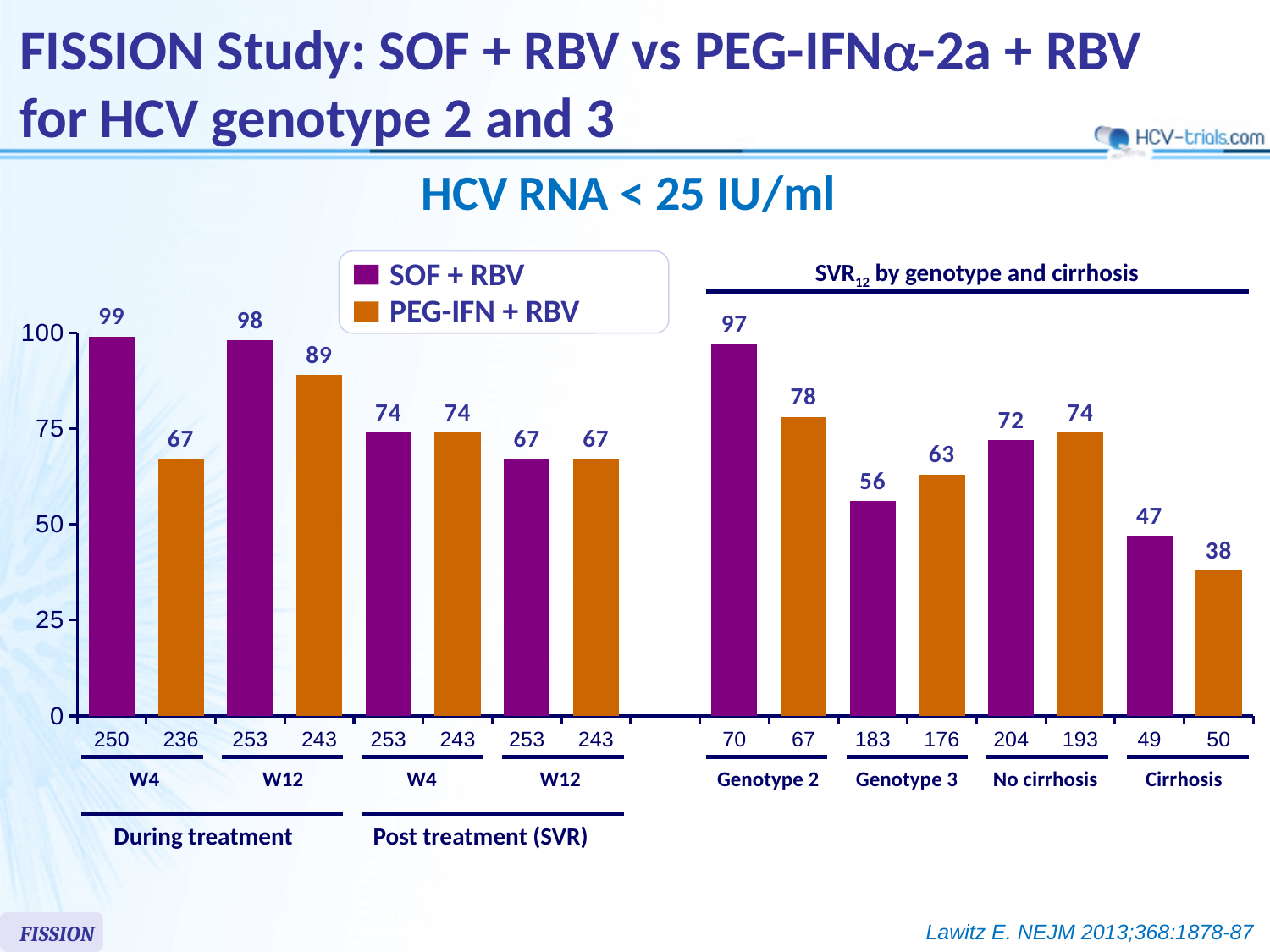
Which category has the highest SOF + RBV value? W4 during treatment What is the difference between SOF + RBV and PEG-IFN + RBV at W4 during treatment? 32 How many series does the legend list? 2 For Genotype 3, which series has the larger value, SOF + RBV or PEG-IFN + RBV? PEG-IFN + RBV What kind of chart is shown on the slide? Bar chart What is the value for SOF + RBV at W4 during treatment? 99 What is the difference between SOF + RBV and PEG-IFN + RBV for Genotype 2? 19 What is the value for PEG-IFN + RBV at W12 during treatment? 89 In the SVR12 by genotype and cirrhosis section, what is the value for PEG-IFN + RBV in the Cirrhosis group? 38 In the SVR12 by genotype and cirrhosis section, what is the value for SOF + RBV in Genotype 3? 56 Which bar has the lowest value on the chart? PEG-IFN + RBV, Cirrhosis How many categories are shown in the SVR12 by genotype and cirrhosis section? 4